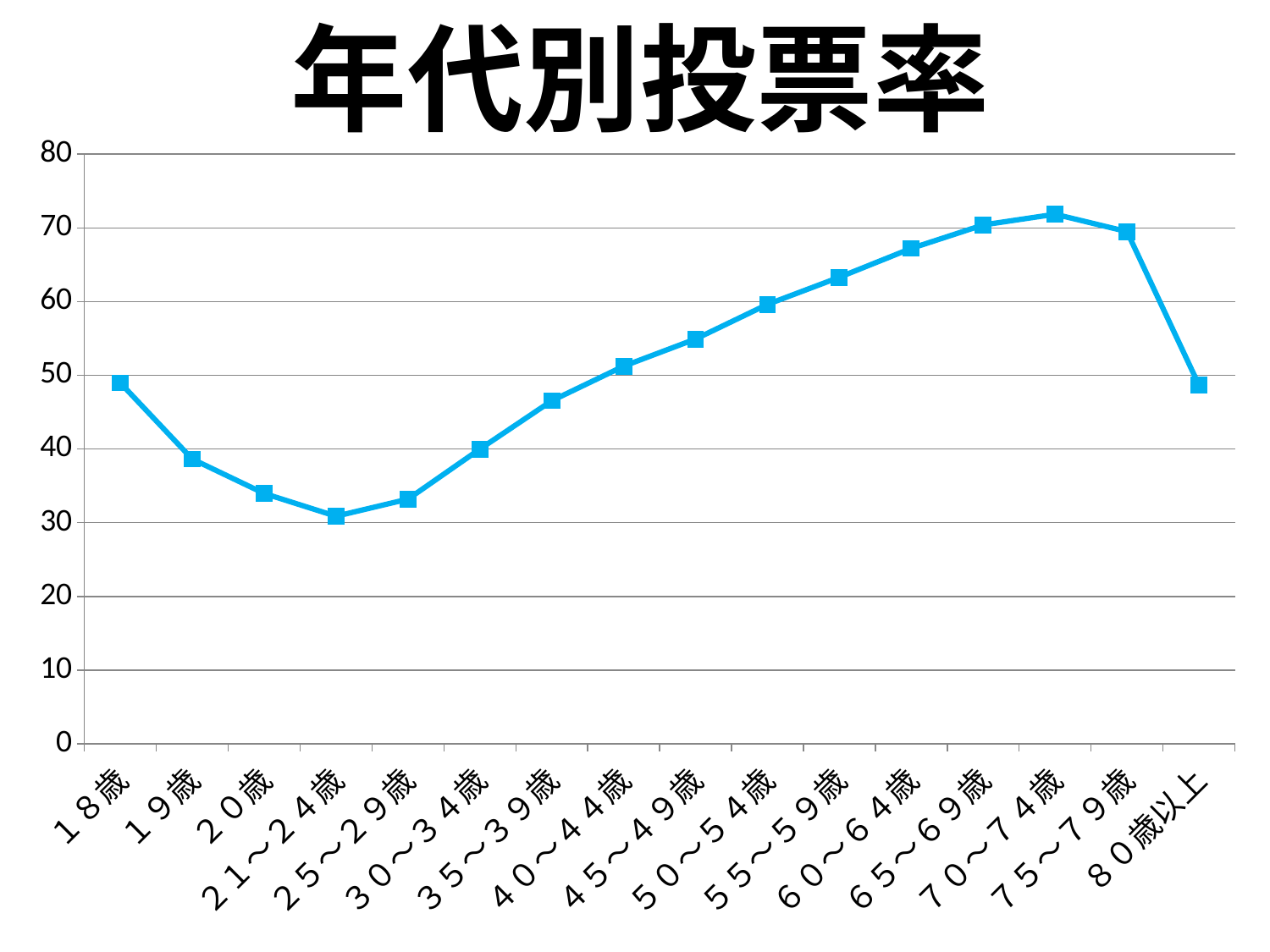
How many age categories are plotted along the x axis? 16 What is the title of the chart? 年代別投票率 Which age category has the highest voting rate? 70～74歳 Which age category has the lowest voting rate? 21～24歳 Which has the higher voting rate, 19歳 or 20歳? 19歳 Which has the higher voting rate, 45～49歳 or 55～59歳? 55～59歳 What kind of chart is shown on the slide? line chart Do the values rise or fall from 21～24歳 to 70～74歳? rise Is the value for 35～39歳 greater or less than 40? greater Is the value for 60～64歳 greater or less than 60? greater Is the value for 70～74歳 greater or less than 70? greater